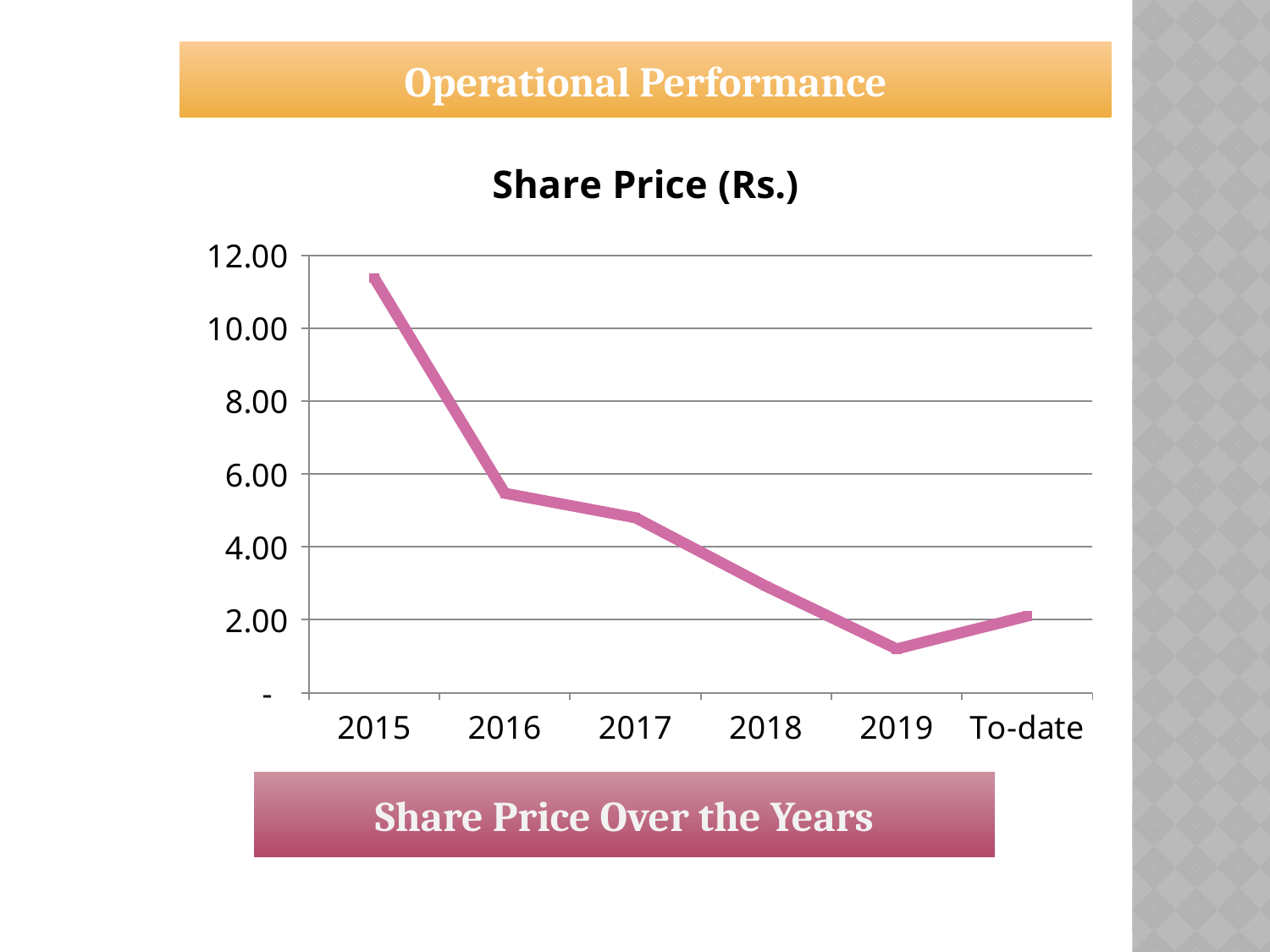
Which is larger, the share price for 2019 or for To-date? To-date What kind of chart is shown on the slide? line chart Is the share price for 2015 greater or less than 10.00? greater Which category has the highest share price? 2015 Does the share price rise or fall from 2015 to 2019? fall Is the share price for 2018 greater or less than 4.00? less Which is larger, the share price for 2015 or for 2016? 2015 Is the share price for 2016 greater or less than 6.00? less Which category has the lowest share price? 2019 What is the title of the chart? Share Price (Rs.) How many points are plotted on the chart? 6